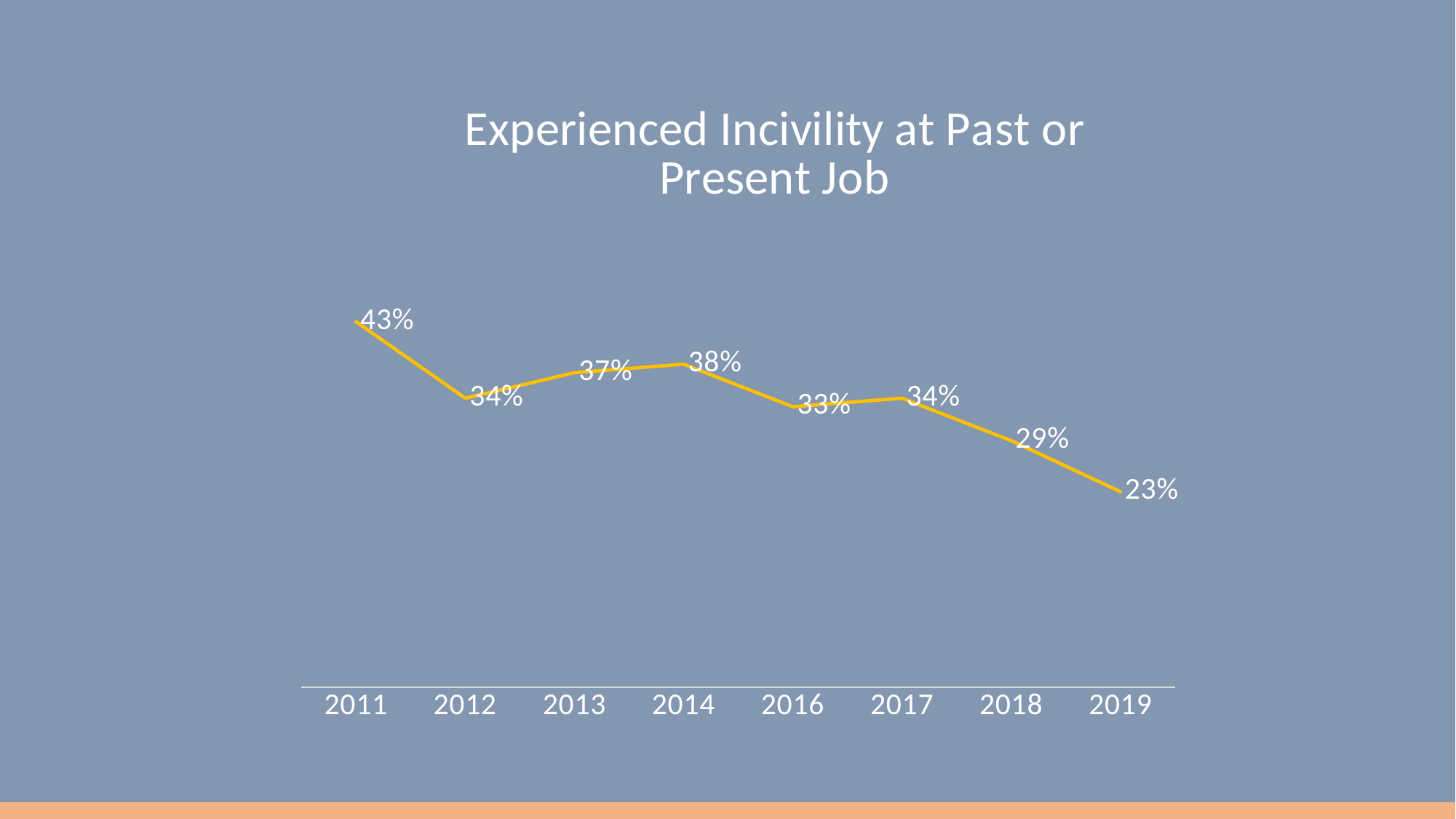
Which is larger, the value for 2013 or the value for 2017? 2013 What is the value for 2019? 23% What is the value for 2018? 29% What is the value for 2014? 38% What is the difference between the values for 2011 and 2019? 20% How many years are plotted on the x axis? 8 What is the value for 2011? 43% What kind of chart is shown? Line chart What is the difference between the values for 2014 and 2016? 5% Which year has the lowest value? 2019 What is the title of the chart? Experienced Incivility at Past or Present Job Which year has the highest value? 2011